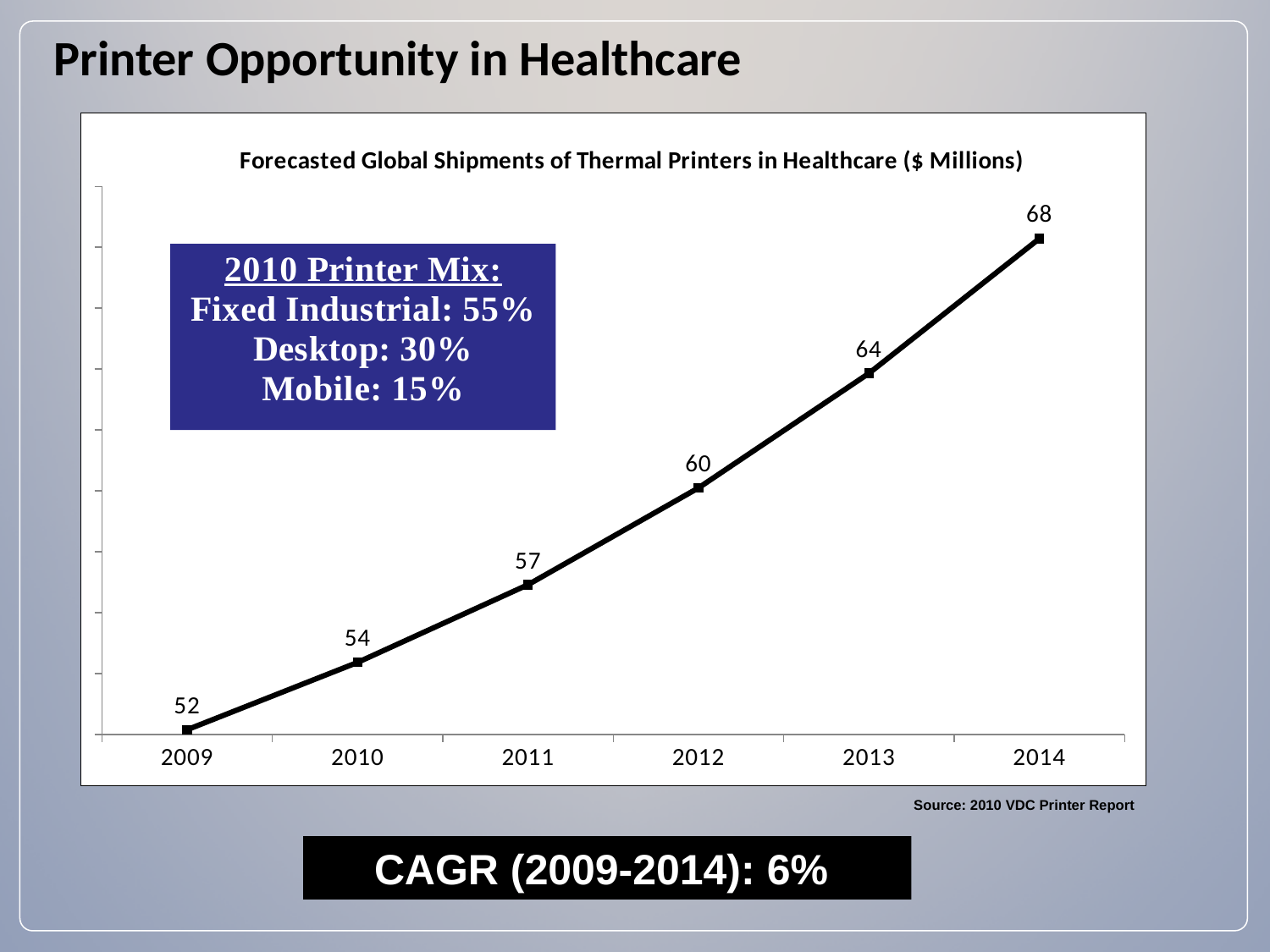
What is the forecasted value for 2009? 52 What is the difference between the 2013 and 2011 values? 7 How many years are plotted on the chart? 6 Which year has the lowest forecasted shipments? 2009 What is the forecasted value for 2014? 68 What is the title of the chart? Forecasted Global Shipments of Thermal Printers in Healthcare ($ Millions) Do the values rise or fall from 2009 to 2014? rise What kind of chart is shown? line chart What is the difference between the 2014 and 2009 values? 16 What is the forecasted value for 2012? 60 Which is larger, the value for 2010 or the value for 2011? 2011 Which year has the highest forecasted shipments? 2014